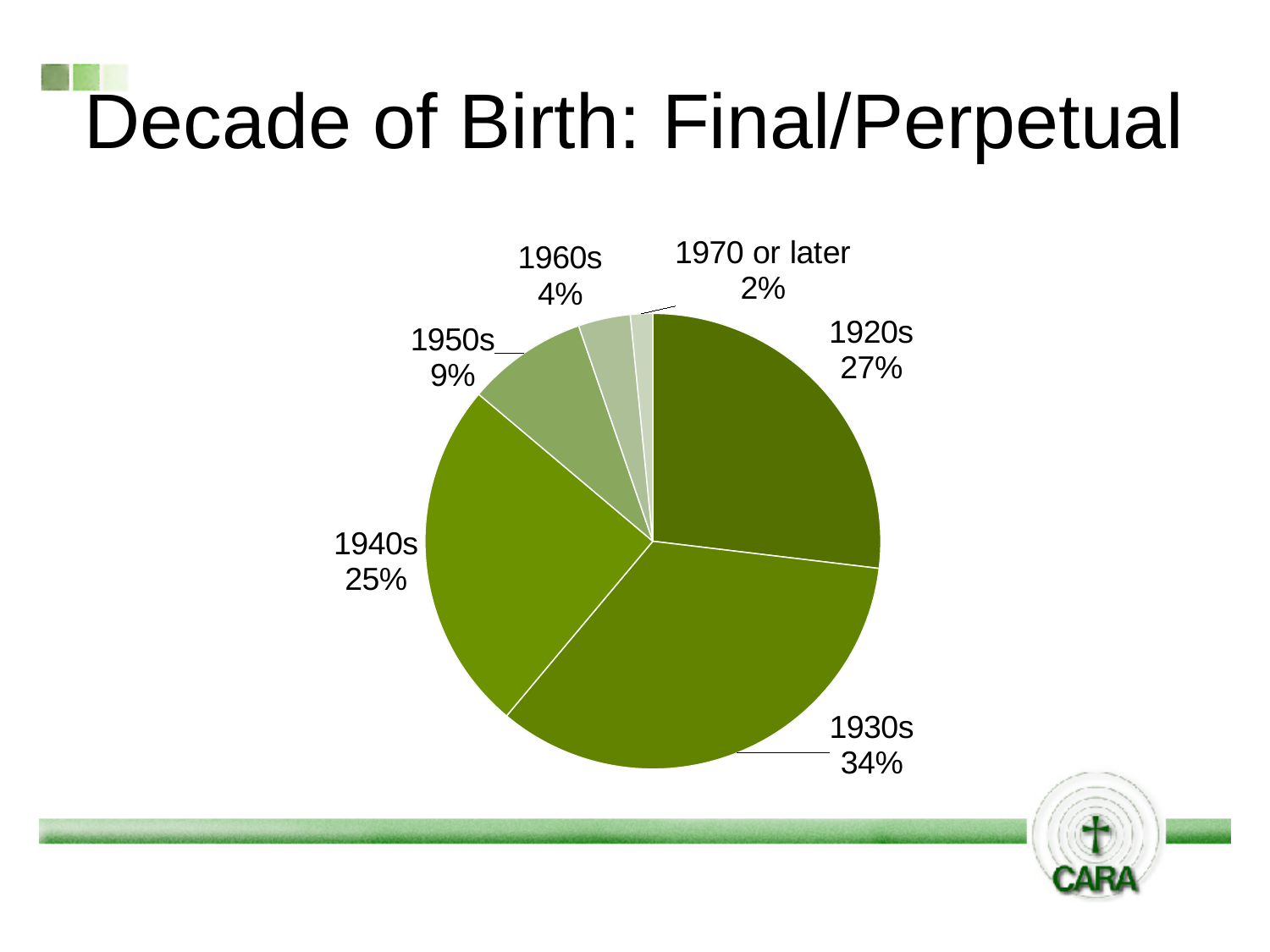
What share of the pie is the 1920s slice? 27% What is the title of the slide? Decade of Birth: Final/Perpetual Which slice is larger, 1950s or 1960s? 1950s What is the difference in percentage points between the 1930s and 1940s slices? 9 What kind of chart is shown on the slide? pie chart Which category has the smallest slice? 1970 or later How many slices does the pie chart have? 6 What share of the pie is the 1930s slice? 34% What share of the pie is the 1940s slice? 25% Which decade of birth has the largest slice? 1930s